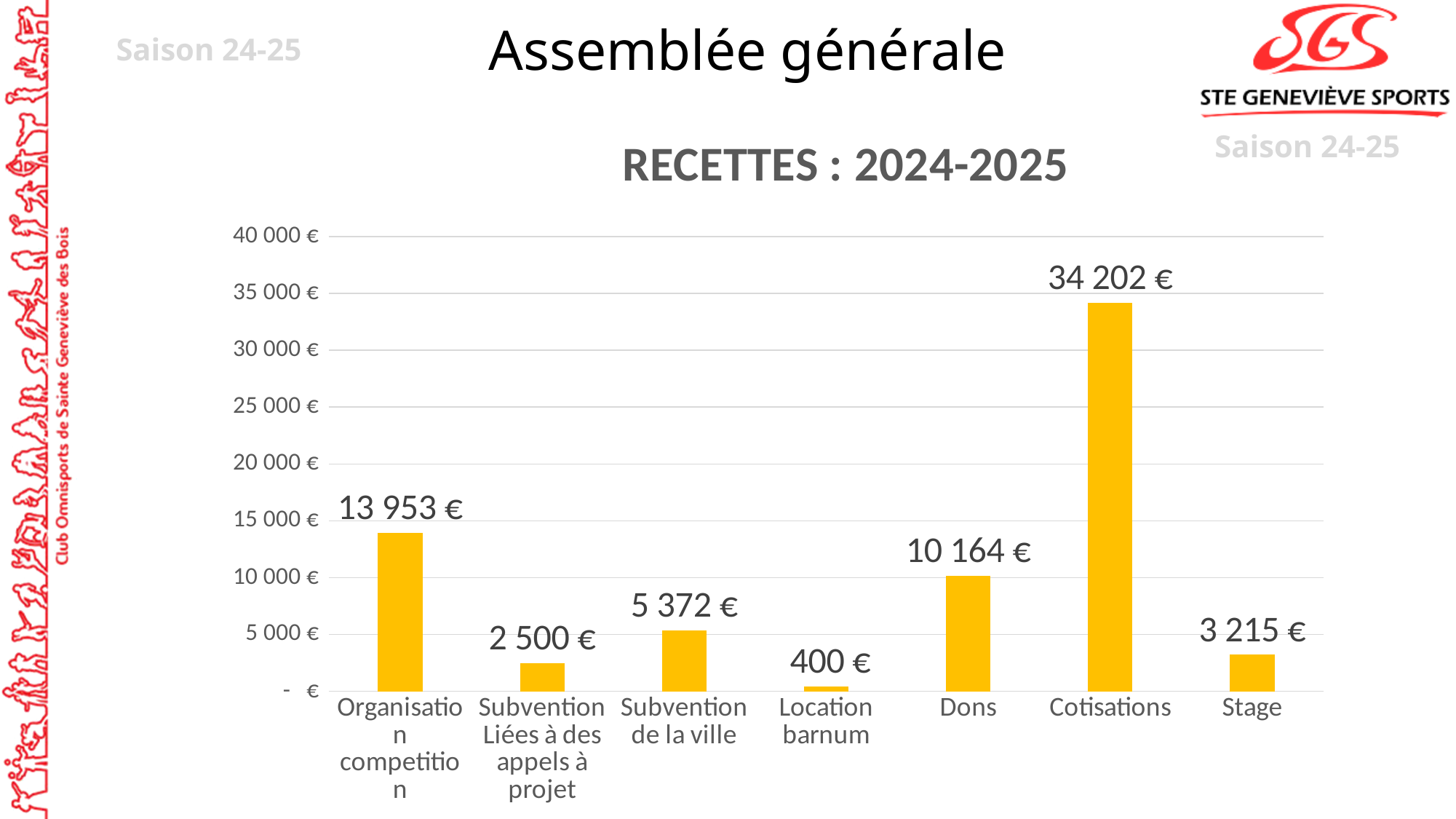
What is the title of the chart? RECETTES : 2024-2025 What is the value for Cotisations? 34 202 € What is the value for Dons? 10 164 € Which category has the highest value? Cotisations What kind of chart is shown? bar chart Which category has the lowest value? Location barnum What is the difference between Cotisations and Organisation competition? 20 249 € What is the value for Subvention de la ville? 5 372 € How many categories are shown on the chart? 7 Which is larger, Dons or Subvention de la ville? Dons What is the value for Location barnum? 400 € Is the value for Organisation competition greater or less than 15 000 €? less